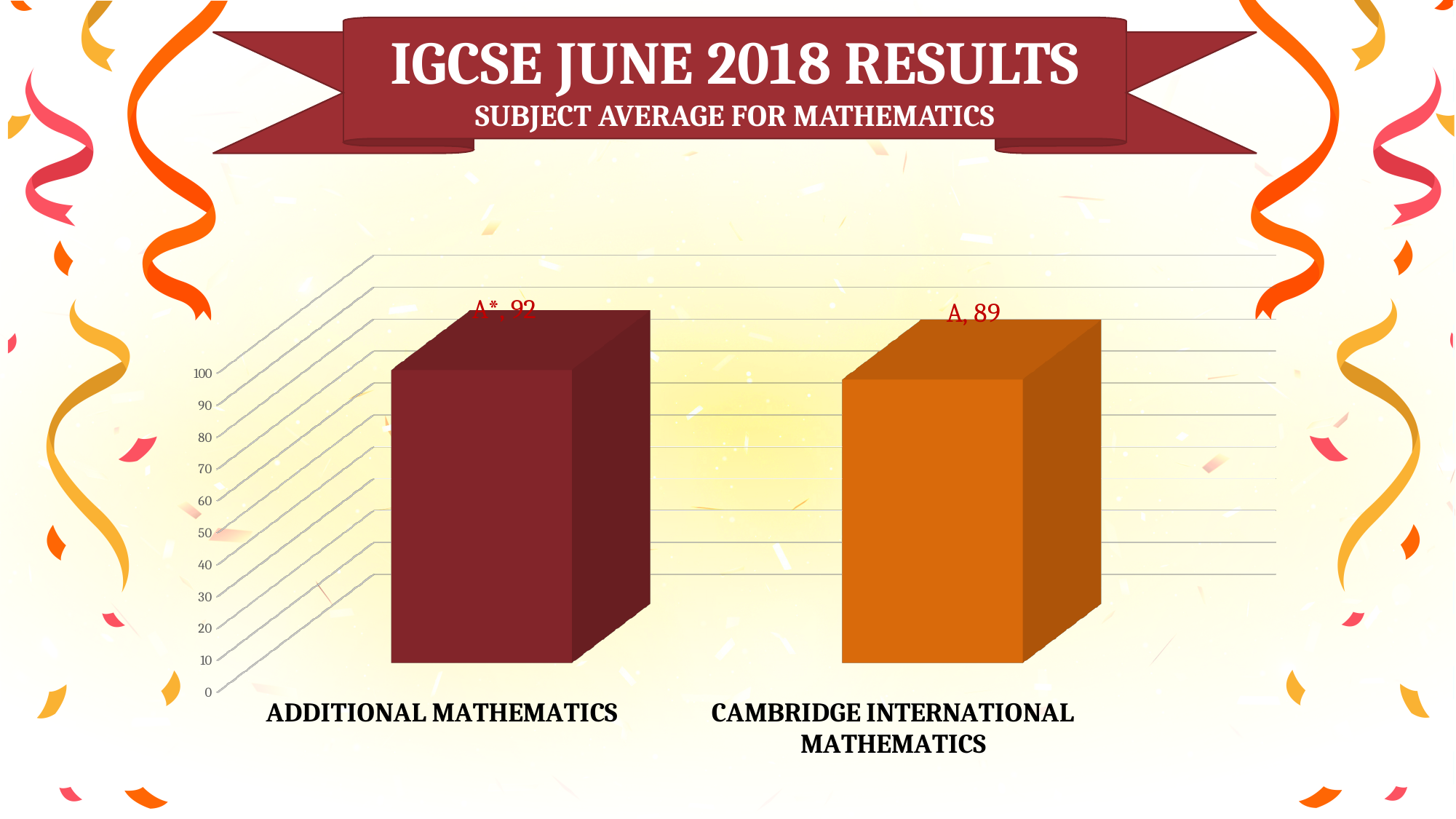
What is the subject average for Additional Mathematics? 92 Which subject has the lower average? Cambridge International Mathematics How many subjects are shown in the chart? 2 Which subject has the higher average? Additional Mathematics What grade label is shown on the Additional Mathematics bar? A* What grade label is shown on the Cambridge International Mathematics bar? A What is the difference between the Additional Mathematics average and the Cambridge International Mathematics average? 3 What is the subtitle of the chart on the slide? Subject Average for Mathematics What kind of chart is shown on the slide? Bar chart Is the average for Cambridge International Mathematics greater or less than 90? less Is the average for Additional Mathematics greater or less than 90? greater What is the subject average for Cambridge International Mathematics? 89